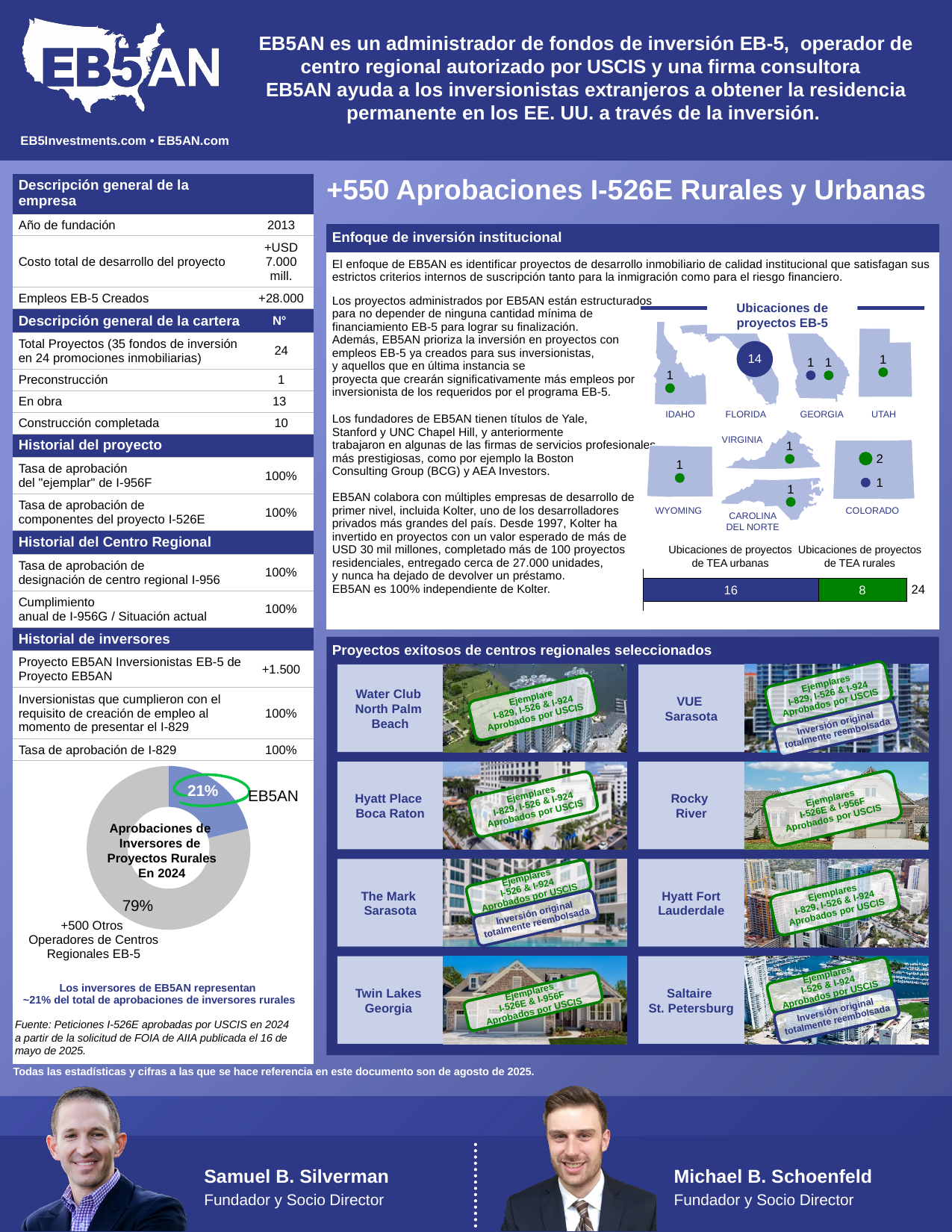
In the stacked bar chart under 'Ubicaciones de proyectos EB-5', what is the value for 'Ubicaciones de proyectos de TEA urbanas'? 16 In the stacked bar chart under 'Ubicaciones de proyectos EB-5', what is the total of the stacked bar? 24 How many segments does the donut chart 'Aprobaciones de Inversores de Proyectos Rurales En 2024' have? 2 In the stacked bar chart under 'Ubicaciones de proyectos EB-5', what is the value for 'Ubicaciones de proyectos de TEA rurales'? 8 In the stacked bar chart under 'Ubicaciones de proyectos EB-5', what is the difference between urban and rural TEA project locations? 8 In the donut chart 'Aprobaciones de Inversores de Proyectos Rurales En 2024', which segment is the smallest? EB5AN In the donut chart 'Aprobaciones de Inversores de Proyectos Rurales En 2024', what share is attributed to EB5AN? 21% In the stacked bar chart under 'Ubicaciones de proyectos EB-5', which is larger: urban TEA project locations or rural TEA project locations? Ubicaciones de proyectos de TEA urbanas In the donut chart 'Aprobaciones de Inversores de Proyectos Rurales En 2024', what is the difference in percentage points between the two segments? 58 In the donut chart 'Aprobaciones de Inversores de Proyectos Rurales En 2024', which segment is the largest? +500 Otros Operadores de Centros Regionales EB-5 In the donut chart 'Aprobaciones de Inversores de Proyectos Rurales En 2024', what share is attributed to '+500 Otros Operadores de Centros Regionales EB-5'? 79% What type of chart is 'Aprobaciones de Inversores de Proyectos Rurales En 2024'? Donut (pie) chart